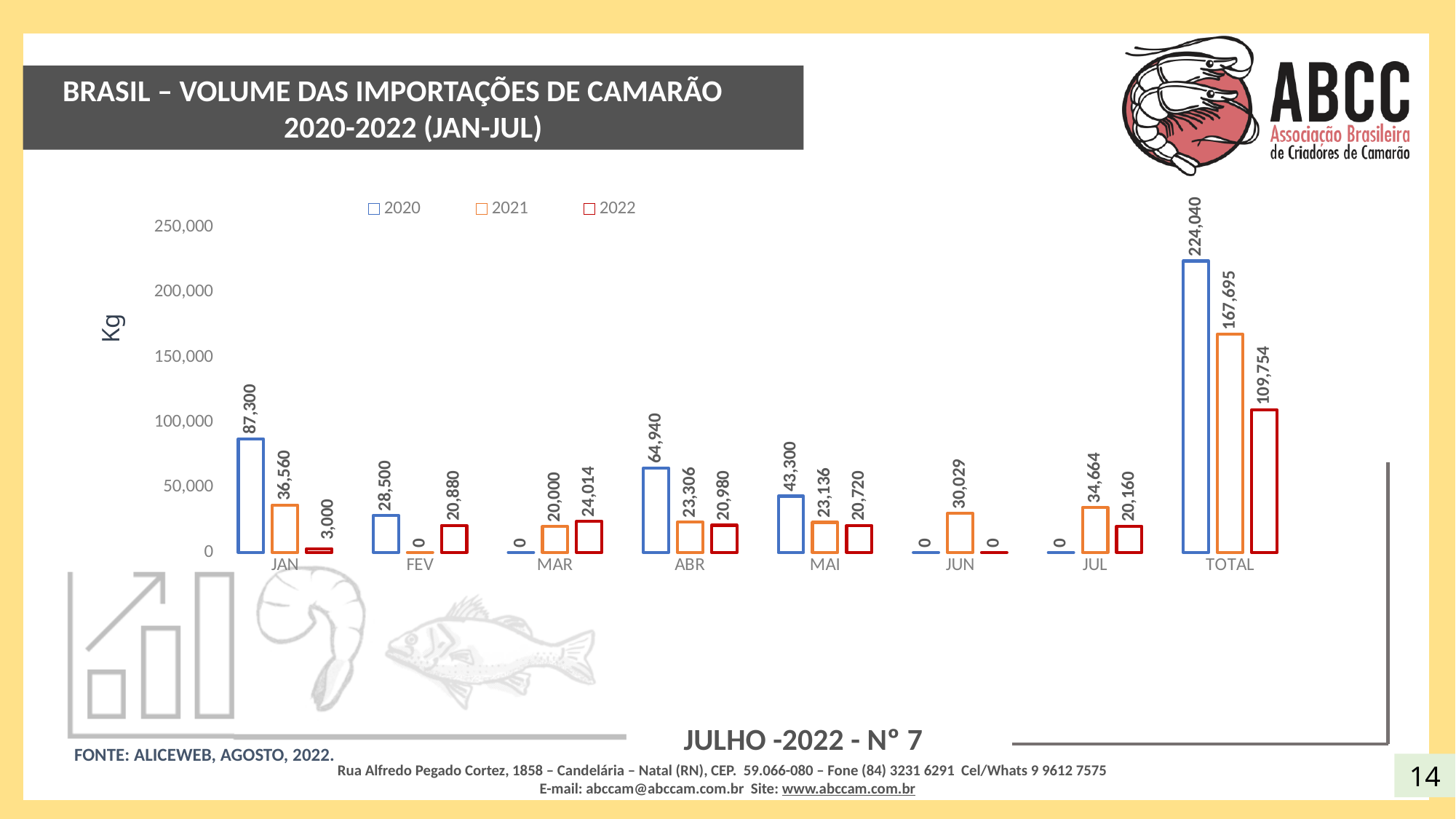
What is the value for 2020 in JAN? 87,300 Among the months JAN to JUL, which month has the highest value for 2020? JAN What is the difference between the TOTAL values for 2020 and 2021? 56,345 Is the TOTAL value for 2020 greater or less than 200,000? greater In ABR, which series has the larger value, 2020 or 2021? 2020 How many series does the legend list? 3 What is the value for 2022 in MAR? 24,014 Among the months JAN to JUL, which month has the lowest value for 2022? JUN What kind of chart is shown on the slide? bar chart What is the TOTAL value for the 2021 series? 167,695 What is the value for 2021 in JUN? 30,029 What is the difference between the 2020 and 2021 values in JAN? 50,740